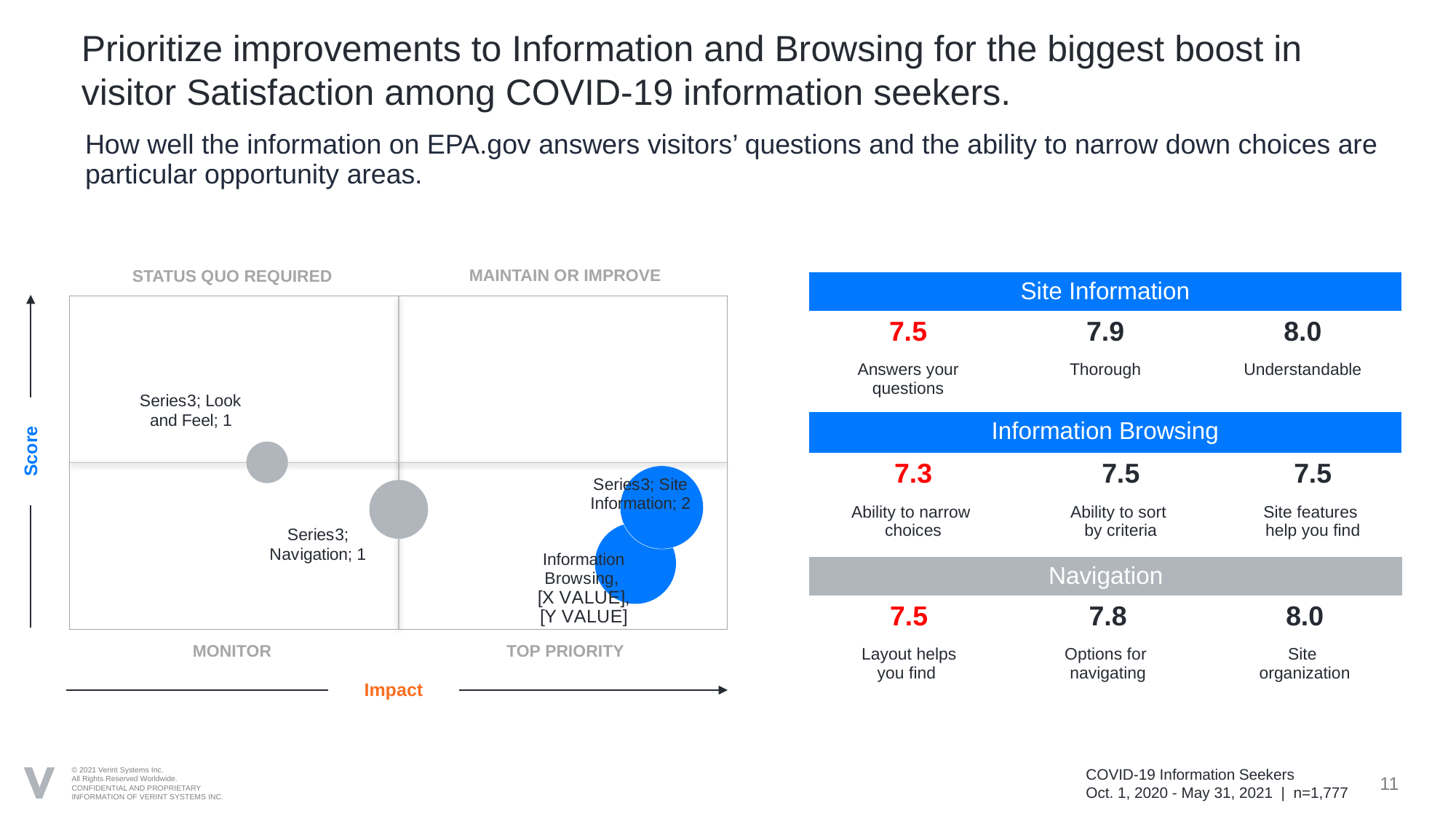
What kind of chart is shown on the left of the slide? bubble chart In the bubble chart, which has the higher Score: Navigation or Look and Feel? Look and Feel How many bubbles are plotted in the chart on the left? 4 In the bubble chart, which quadrant does the Information Browsing bubble fall in? TOP PRIORITY In the bubble chart, which quadrant does the Site Information bubble fall in? TOP PRIORITY In the bubble chart, which bubble has the lowest Impact? Look and Feel In the bubble chart, which bubble has the lowest Score? Information Browsing In the bubble chart, which bubble has the highest Score? Look and Feel In the bubble chart, what bubble size value is shown in the label for Site Information? 2 What is the label of the horizontal axis of the bubble chart? Impact